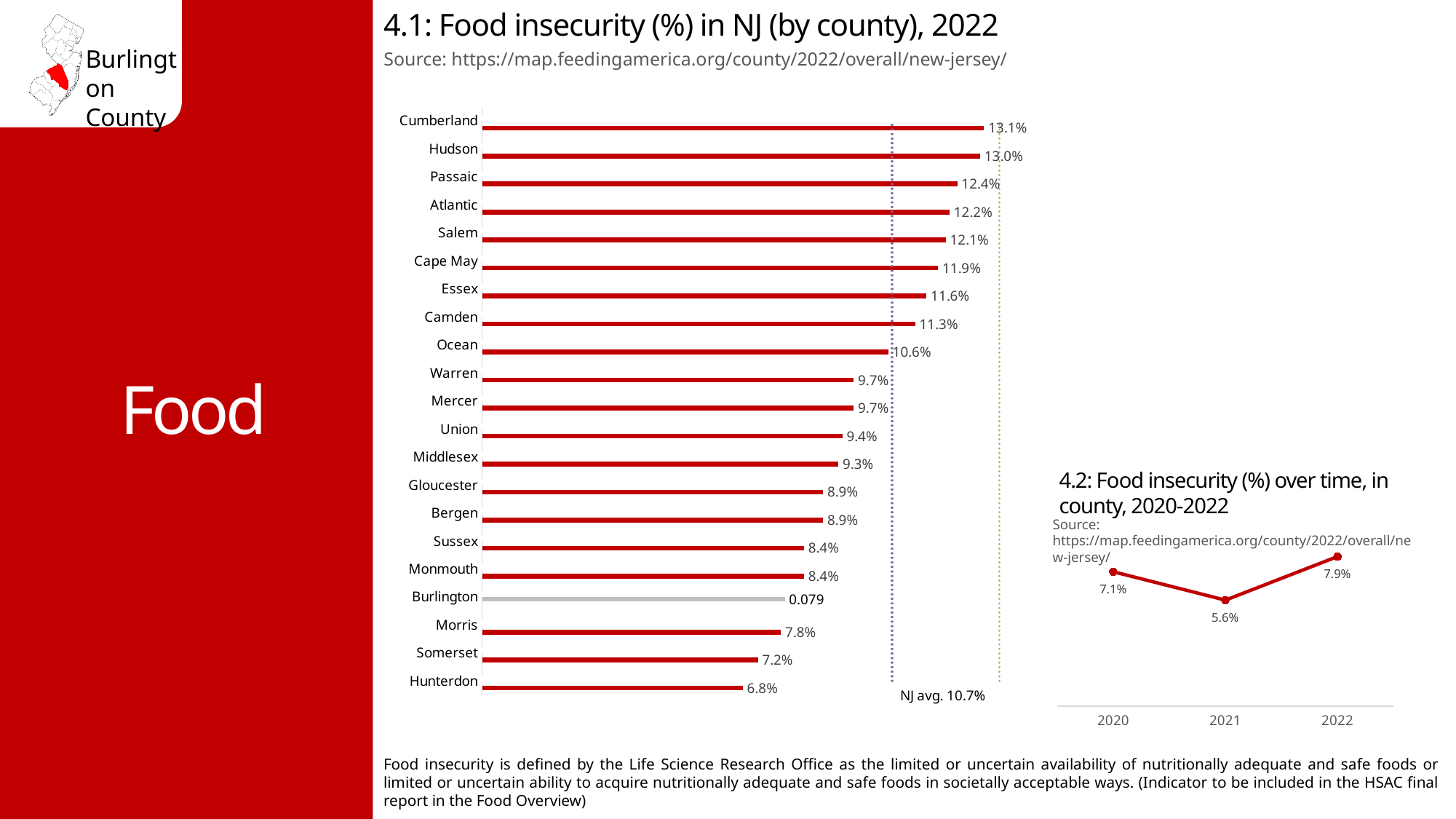
In chart 4.1 (Food insecurity in NJ by county, 2022), how many counties are plotted? 21 In chart 4.1 (Food insecurity in NJ by county, 2022), which has the larger value, Essex or Camden? Essex What kind of chart is chart 4.1 (Food insecurity in NJ by county, 2022)? Bar chart In chart 4.2 (Food insecurity over time in county, 2020-2022), how does the value change from 2020 to 2022? It falls from 2020 to 2021, then rises in 2022 In chart 4.1 (Food insecurity in NJ by county, 2022), what label is shown for Burlington? 0.079 In chart 4.1 (Food insecurity in NJ by county, 2022), what is the value for Cumberland? 13.1% In chart 4.1 (Food insecurity in NJ by county, 2022), which county has the lowest value? Hunterdon In chart 4.2 (Food insecurity over time in county, 2020-2022), what is the value for 2021? 5.6% In chart 4.1 (Food insecurity in NJ by county, 2022), what is the difference between the values for Cumberland and Hunterdon? 6.3% In chart 4.1 (Food insecurity in NJ by county, 2022), what NJ average is marked on the chart? NJ avg. 10.7% What kind of chart is chart 4.2 (Food insecurity over time in county, 2020-2022)? Line chart In chart 4.1 (Food insecurity in NJ by county, 2022), which county has the highest value? Cumberland